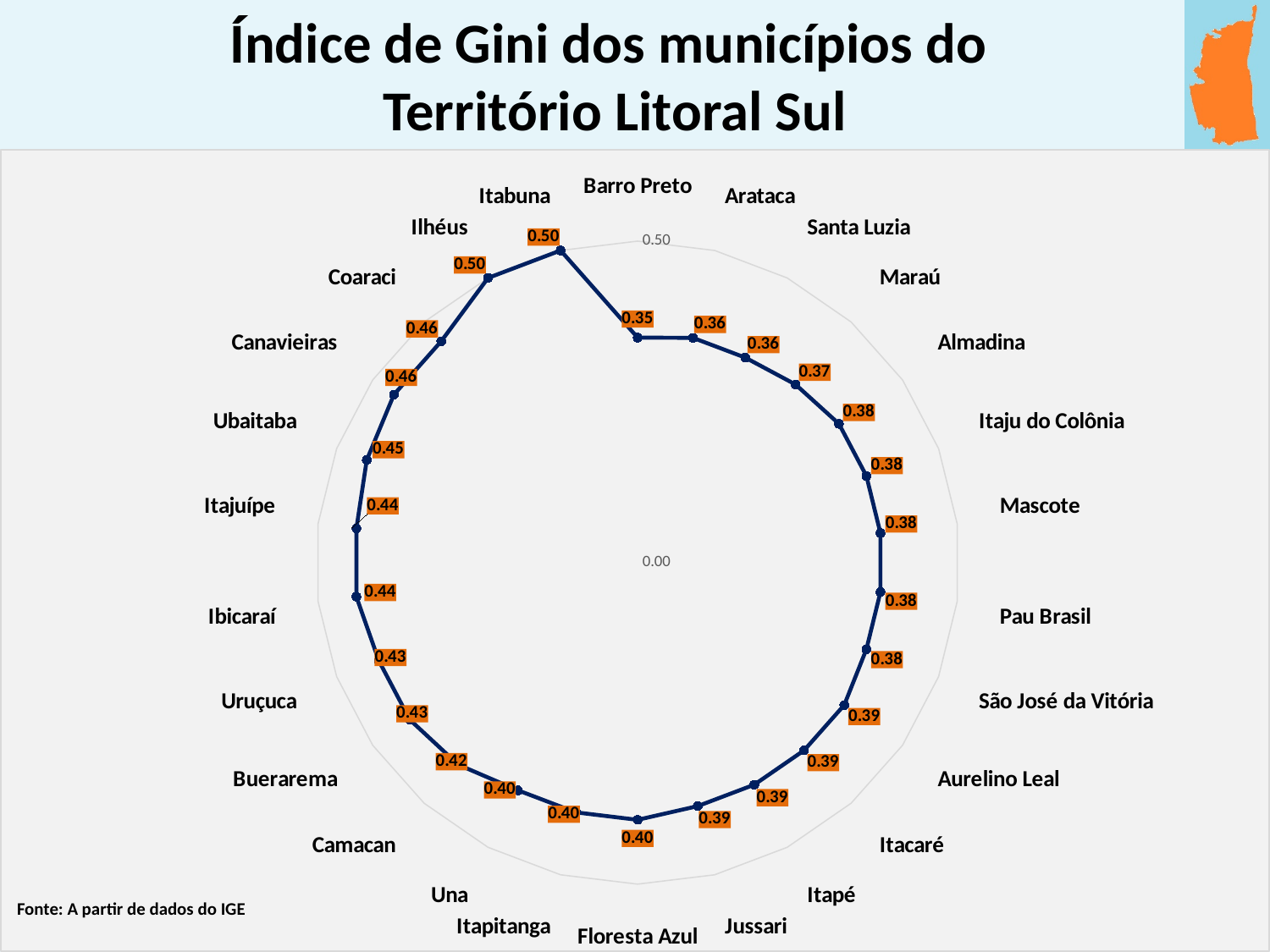
What is the title of the chart? Índice de Gini dos municípios do Território Litoral Sul Which municipality has the lowest Gini index on the chart? Barro Preto What is the Gini index value shown for Ubaitaba? 0.45 Which has a higher Gini index, Coaraci or Mascote? Coaraci What is the highest Gini index value shown on the chart? 0.50 What is the Gini index value shown for Camacan? 0.42 What is the Gini index value shown for Maraú? 0.37 What is the difference between the Gini index of Itabuna and that of Barro Preto? 0.15 What type of chart is shown on the slide? Radar chart How many municipalities are plotted on the chart? 26 What is the source cited for the chart data? A partir de dados do IGE What is the Gini index value shown for Barro Preto? 0.35